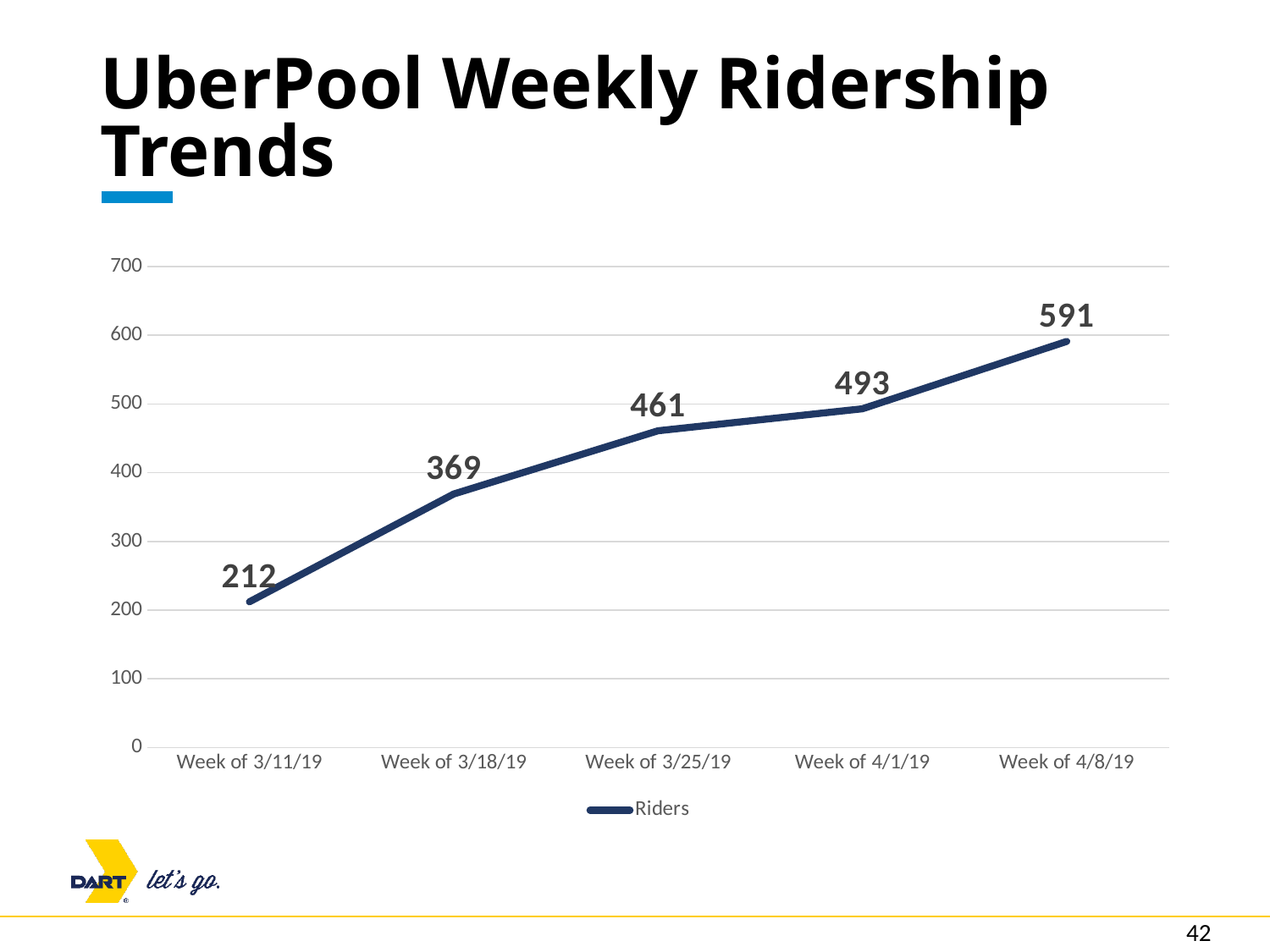
What is the difference in riders between the Week of 3/18/19 and the Week of 3/25/19? 92 What is the number of riders for the Week of 3/25/19? 461 What kind of chart is shown on the slide? Line chart What is the number of riders for the Week of 3/11/19? 212 How many weeks are plotted on the chart? 5 How many series does the legend list? 1 What is the difference in riders between the Week of 4/8/19 and the Week of 3/11/19? 379 Which week has the lowest number of riders? Week of 3/11/19 What is the number of riders for the Week of 4/1/19? 493 Do the rider numbers rise or fall from the Week of 3/11/19 to the Week of 4/8/19? Rise Which week has the highest number of riders? Week of 4/8/19 Which week has more riders, the Week of 3/18/19 or the Week of 4/1/19? Week of 4/1/19